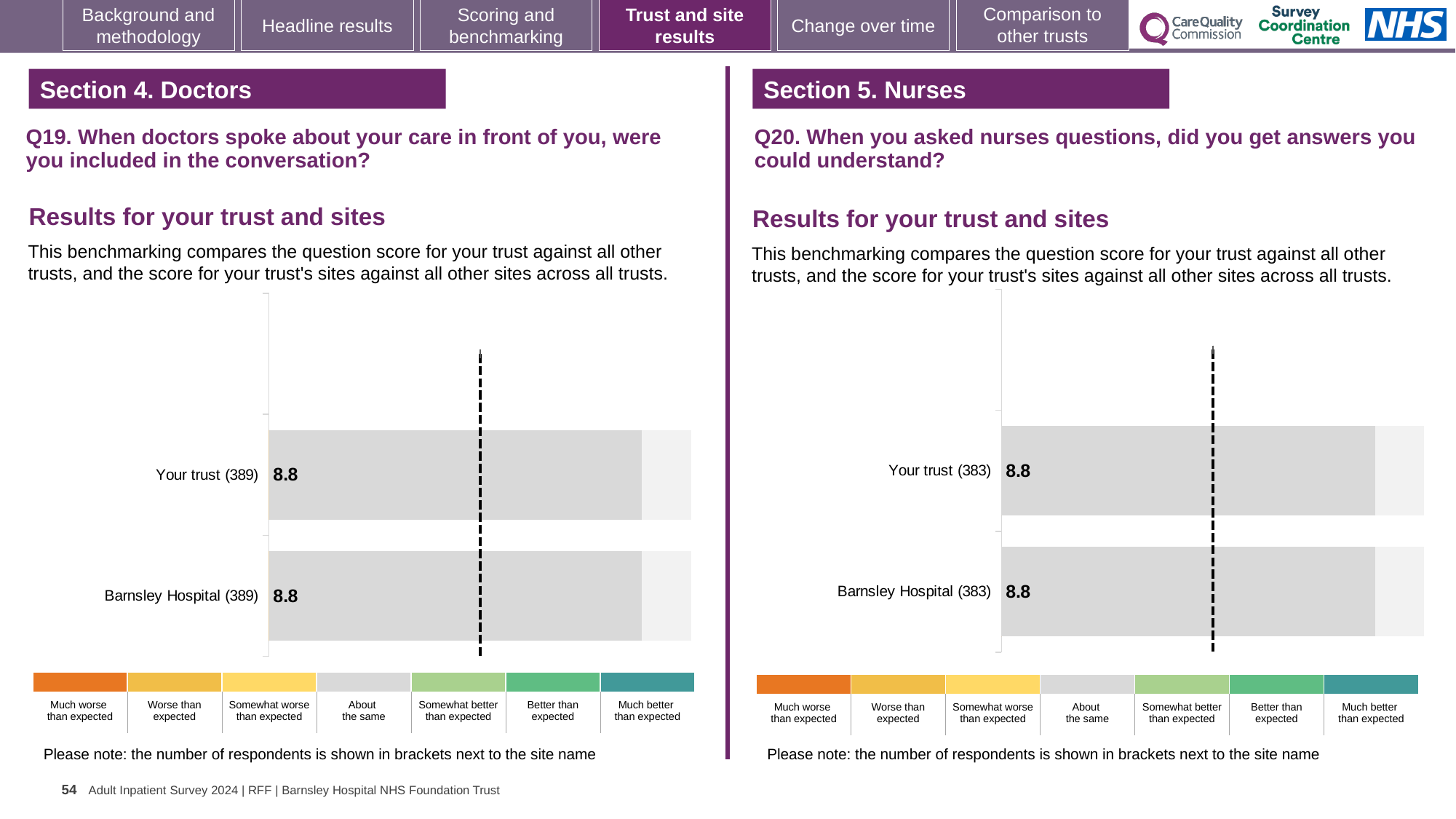
What kind of chart is used for the Q19 results on the left? Bar chart In the Q19 chart on the left, what is the score for Barnsley Hospital? 8.8 In the Q20 chart on the right, what is the difference between the scores for Your trust and Barnsley Hospital? 0 In the Q20 chart on the right, what is the score for Your trust? 8.8 How many bars are plotted in the Q19 chart on the left? 2 In the Q19 chart on the left, what is the score for Your trust? 8.8 In the Q20 chart on the right, what is the score for Barnsley Hospital? 8.8 How many bars are plotted in the Q20 chart on the right? 2 In the Q19 chart on the left, how many respondents are shown in brackets next to Your trust? 389 In the Q19 chart on the left, what is the difference between the scores for Your trust and Barnsley Hospital? 0 In the Q20 chart on the right, how many respondents are shown in brackets next to Barnsley Hospital? 383